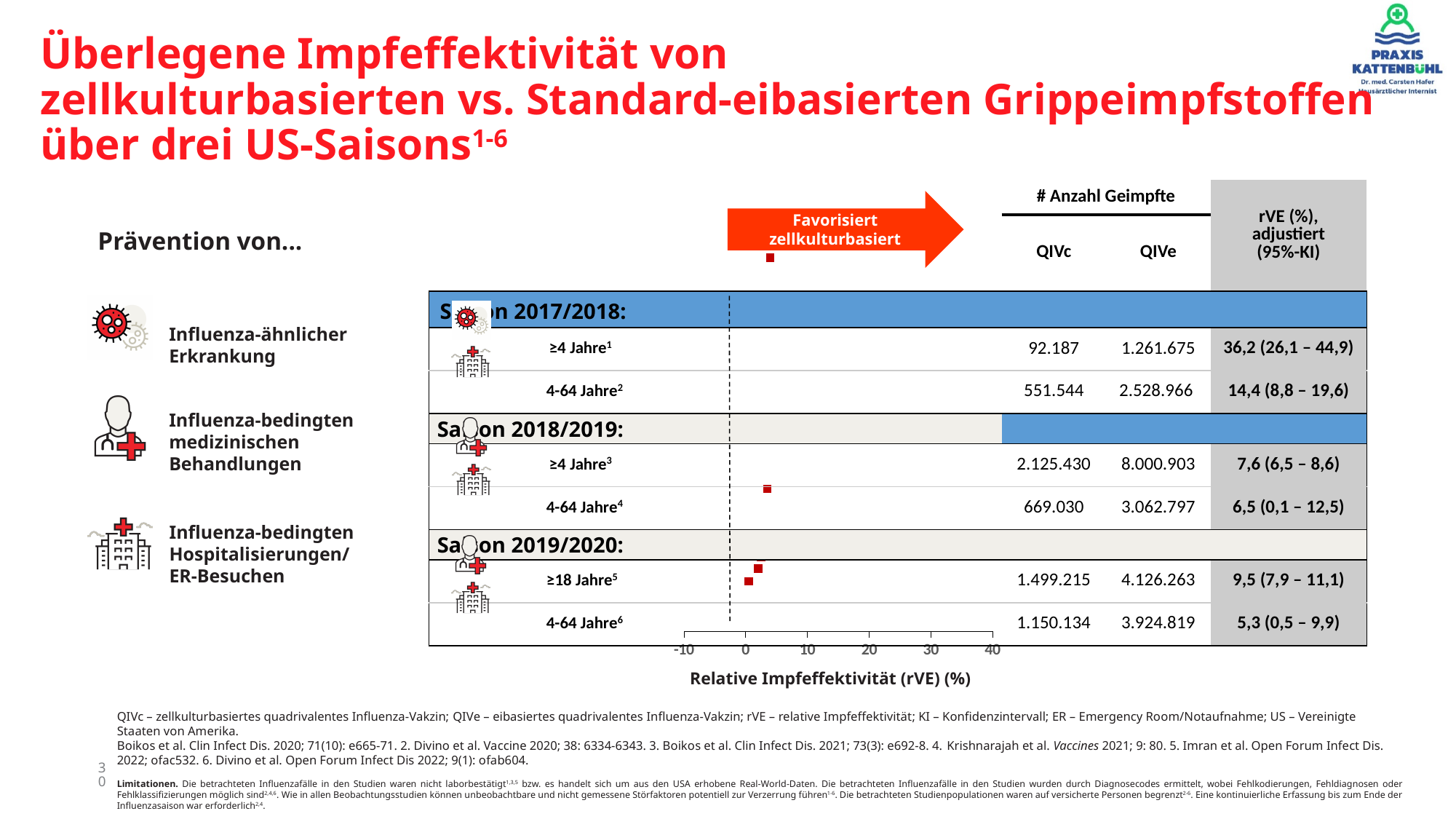
What is the difference between the rVE point estimates for ≥4 Jahre and 4-64 Jahre in Saison 2017/2018? 21,8 How many QIVe vaccinated persons are listed for 4-64 Jahre in Saison 2017/2018? 2.528.966 What is the highest tick value shown on the x axis? 40 What is the adjusted rVE (%) with 95% CI for ≥4 Jahre in Saison 2017/2018? 36,2 (26,1 – 44,9) What is the label of the x axis of the chart? Relative Impfeffektivität (rVE) (%) How many age-group rows (data points) are shown across the three seasons? 6 Which age group and season has the lowest adjusted rVE point estimate? 4-64 Jahre, Saison 2019/2020 What is the adjusted rVE (%) with 95% CI for 4-64 Jahre in Saison 2018/2019? 6,5 (0,1 – 12,5) In Saison 2018/2019, which age group has the larger rVE point estimate, ≥4 Jahre or 4-64 Jahre? ≥4 Jahre How many QIVc vaccinated persons are listed for ≥18 Jahre in Saison 2019/2020? 1.499.215 Is the rVE point estimate for ≥18 Jahre in Saison 2019/2020 greater or less than 10? less Which age group and season has the highest adjusted rVE point estimate? ≥4 Jahre, Saison 2017/2018